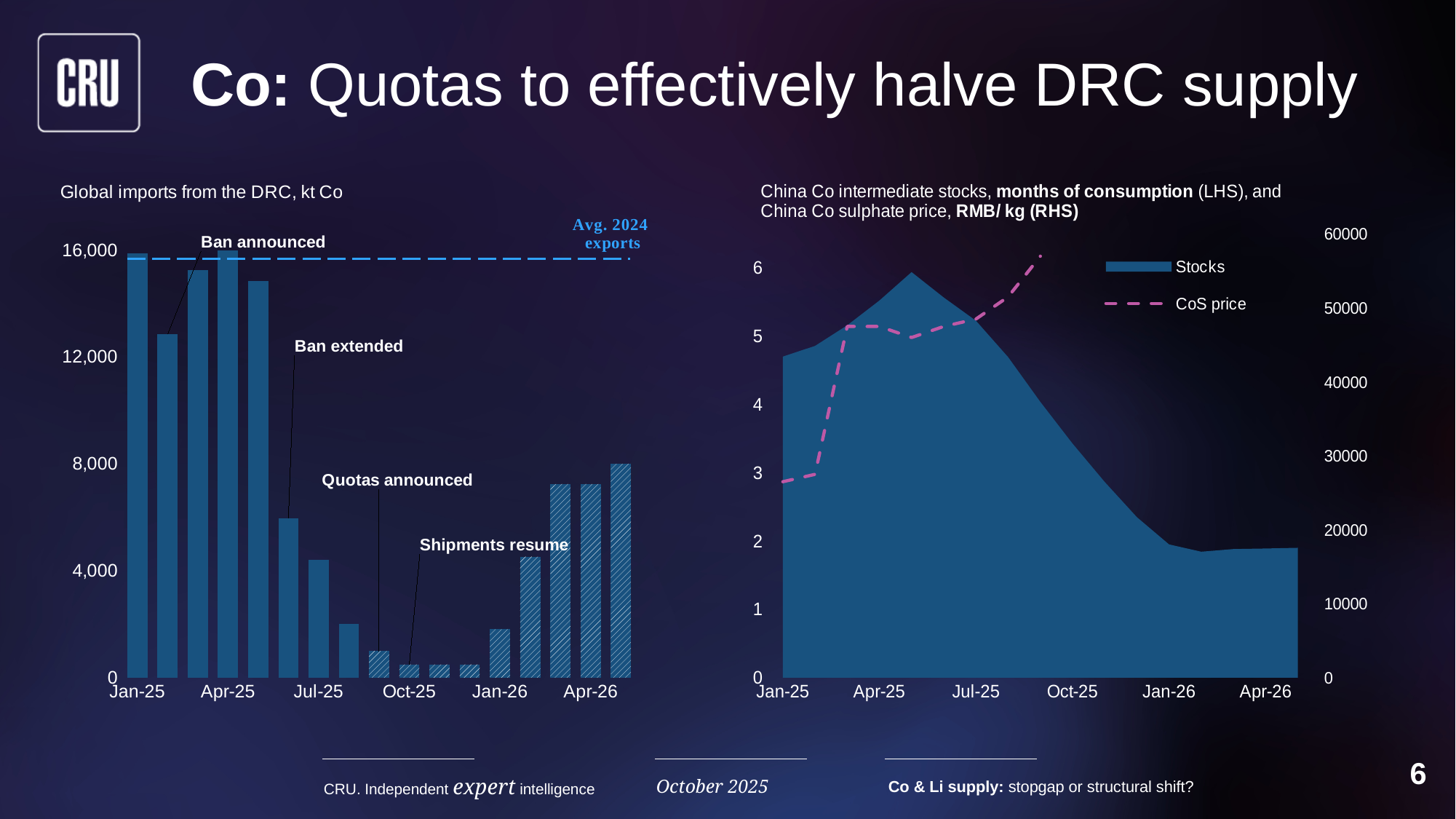
How many series does the legend of the right chart (China Co intermediate stocks and sulphate price) list? 2 On the left chart 'Global imports from the DRC', do the values rise or fall from Jan-25 to Oct-25? fall On the right chart, does the CoS price rise or fall from Jan-25 to its last plotted point? rise On the right chart, is the CoS price at Jan-25 greater or less than 30000? less On the right chart, is the Stocks value for Jan-26 greater or less than 3? less On the left chart 'Global imports from the DRC', which is larger, the value for Jan-25 or the value for Jul-25? Jan-25 On the left chart 'Global imports from the DRC', what does the blue dashed horizontal line represent? Avg. 2024 exports On the left chart 'Global imports from the DRC', is the value for Apr-26 greater or less than 8,000? less What type of chart is the left chart, 'Global imports from the DRC, kt Co'? bar chart